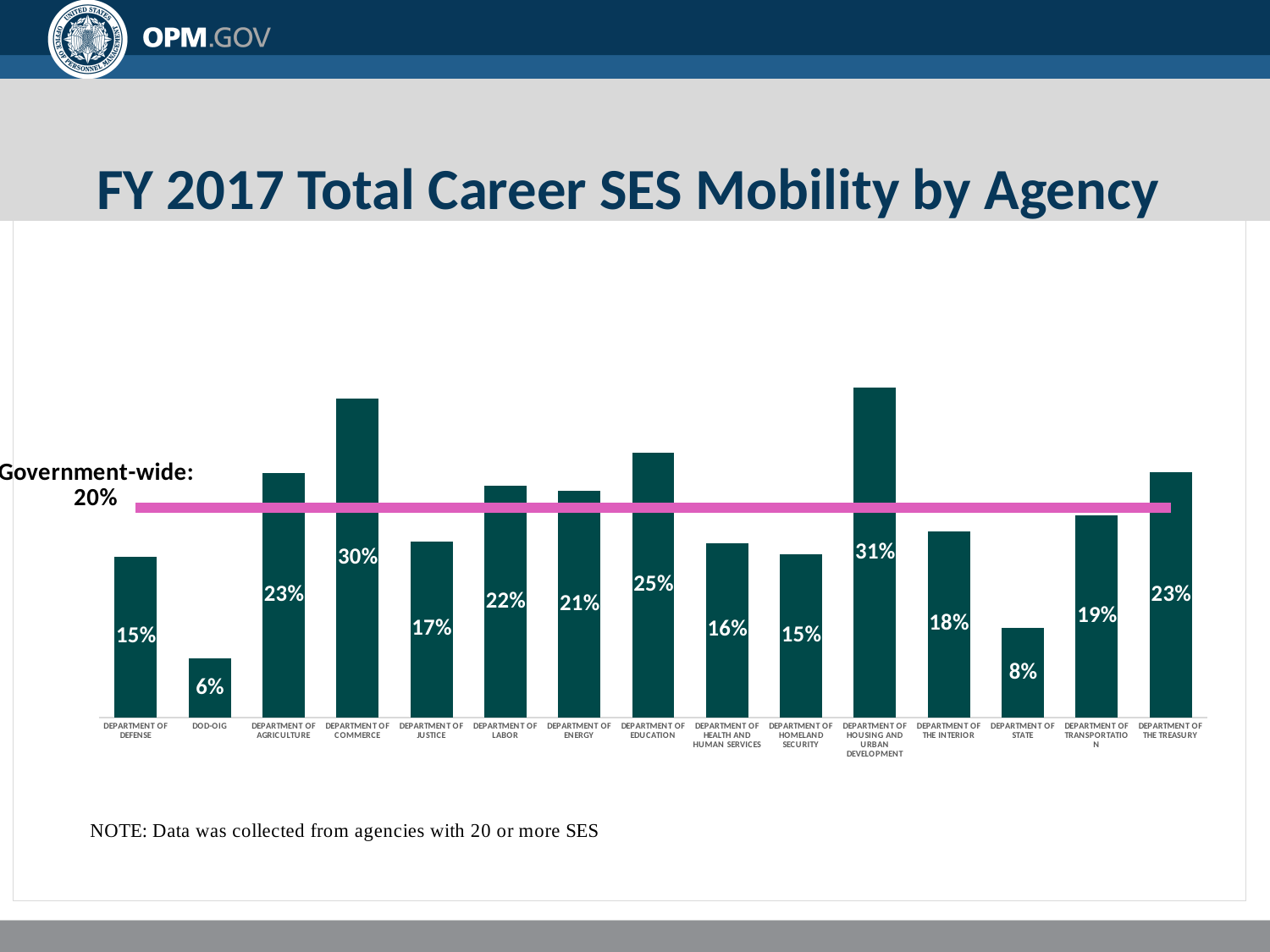
What is the difference between the Department of Commerce and the Department of Justice? 13% What is the difference between the Department of Housing and Urban Development and DOD-OIG? 25% How many agencies are shown in the chart? 15 What is the value for the Department of Commerce? 30% What kind of chart is shown on the slide? Bar chart What is the value for the Department of State? 8% What is the title of the chart? FY 2017 Total Career SES Mobility by Agency What is the value for the Department of Education? 25% Which is larger, the Department of Labor or the Department of the Interior? Department of Labor Which agency has the lowest value? DOD-OIG Which agency has the highest value? Department of Housing and Urban Development What is the government-wide value marked by the horizontal line? 20%